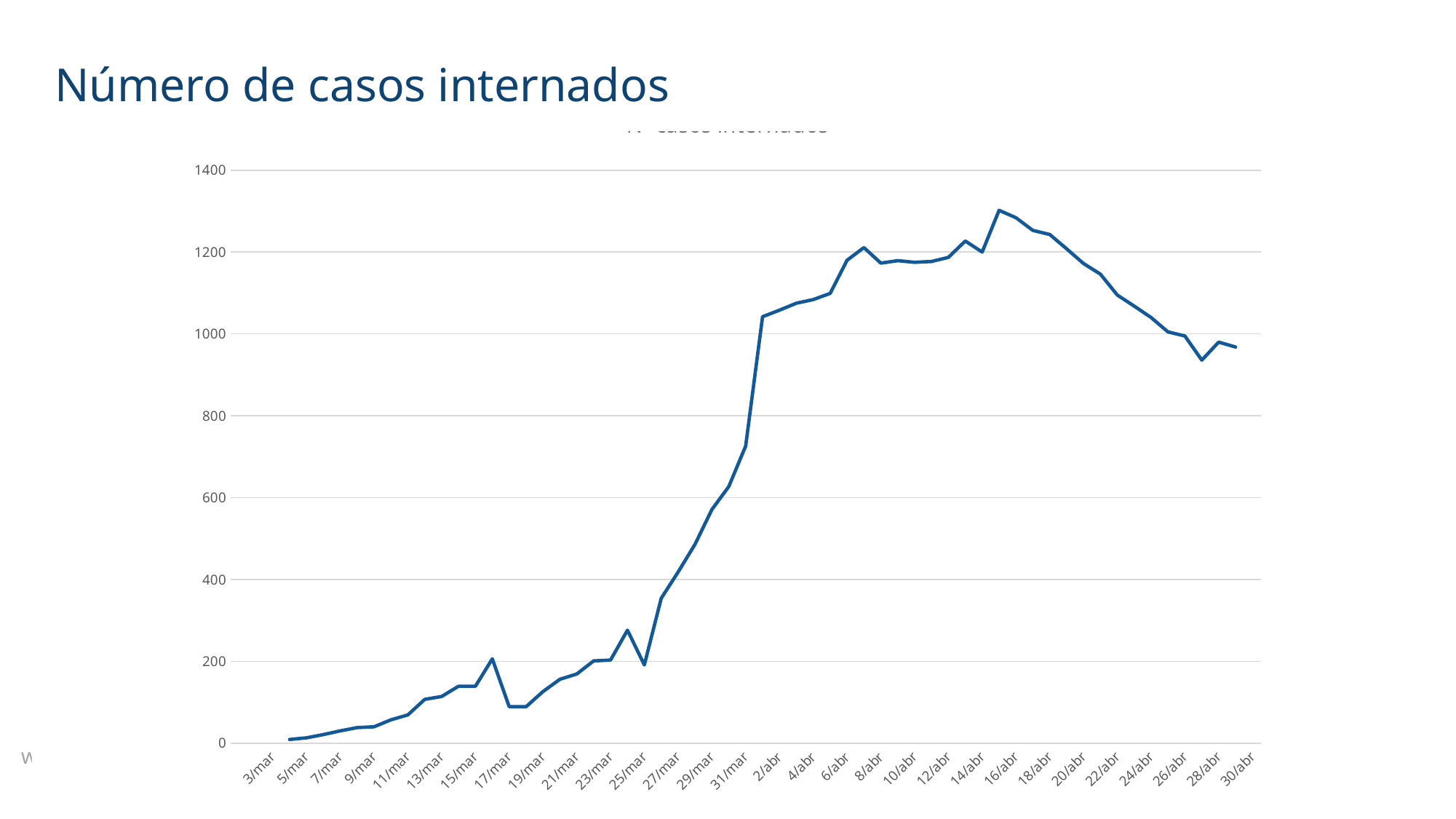
Is the highest value on the chart greater or less than 1200? greater What kind of chart is shown on the slide? line chart Does the peak of the line occur in March or April? April What is the title of the slide? Número de casos internados Is the value for 31/mar greater or less than 600? greater Do the values rise or fall between 16/abr and 30/abr? fall Is the value for 2/abr greater or less than 1000? greater